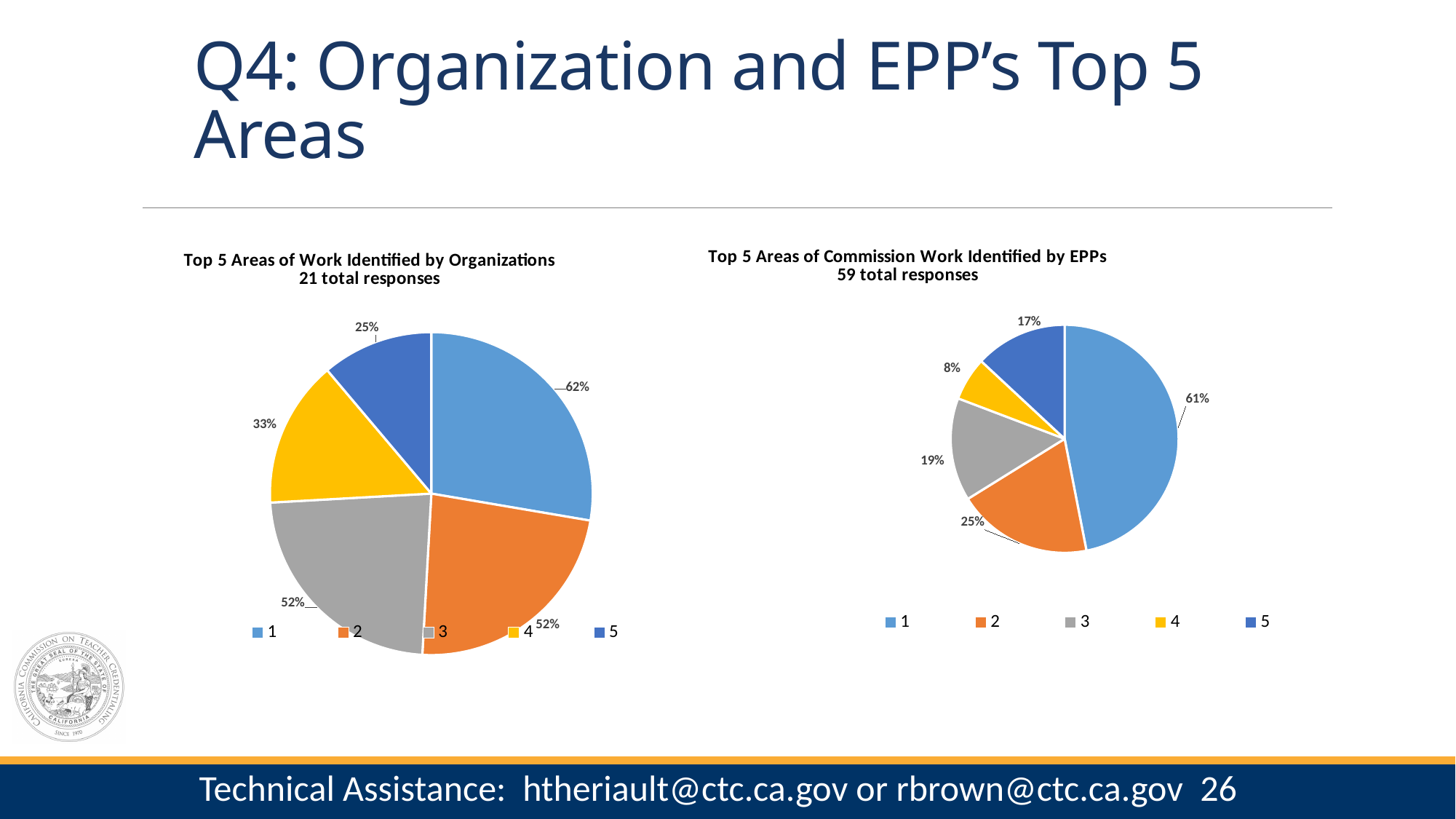
In the chart titled "Top 5 Areas of Commission Work Identified by EPPs", which category has the largest slice? 1 In the chart titled "Top 5 Areas of Commission Work Identified by EPPs", which category has the smallest slice? 4 In the chart titled "Top 5 Areas of Work Identified by Organizations", what percentage is shown for category 1? 62% In the chart titled "Top 5 Areas of Work Identified by Organizations", which category has the largest slice? 1 In the chart titled "Top 5 Areas of Commission Work Identified by EPPs", which is larger, category 3 or category 5? 3 In the chart titled "Top 5 Areas of Commission Work Identified by EPPs", what is the difference in percentage points between category 1 and category 2? 36 In the chart titled "Top 5 Areas of Commission Work Identified by EPPs", what percentage is shown for category 2? 25% In the chart titled "Top 5 Areas of Work Identified by Organizations", which category has the smallest slice? 5 In the chart titled "Top 5 Areas of Commission Work Identified by EPPs", what percentage is shown for category 5? 17% What type of chart is the chart on the right of the slide? Pie chart In the chart titled "Top 5 Areas of Work Identified by Organizations", what percentage is shown for category 4? 33% In the chart titled "Top 5 Areas of Work Identified by Organizations", how many slices does the pie have? 5